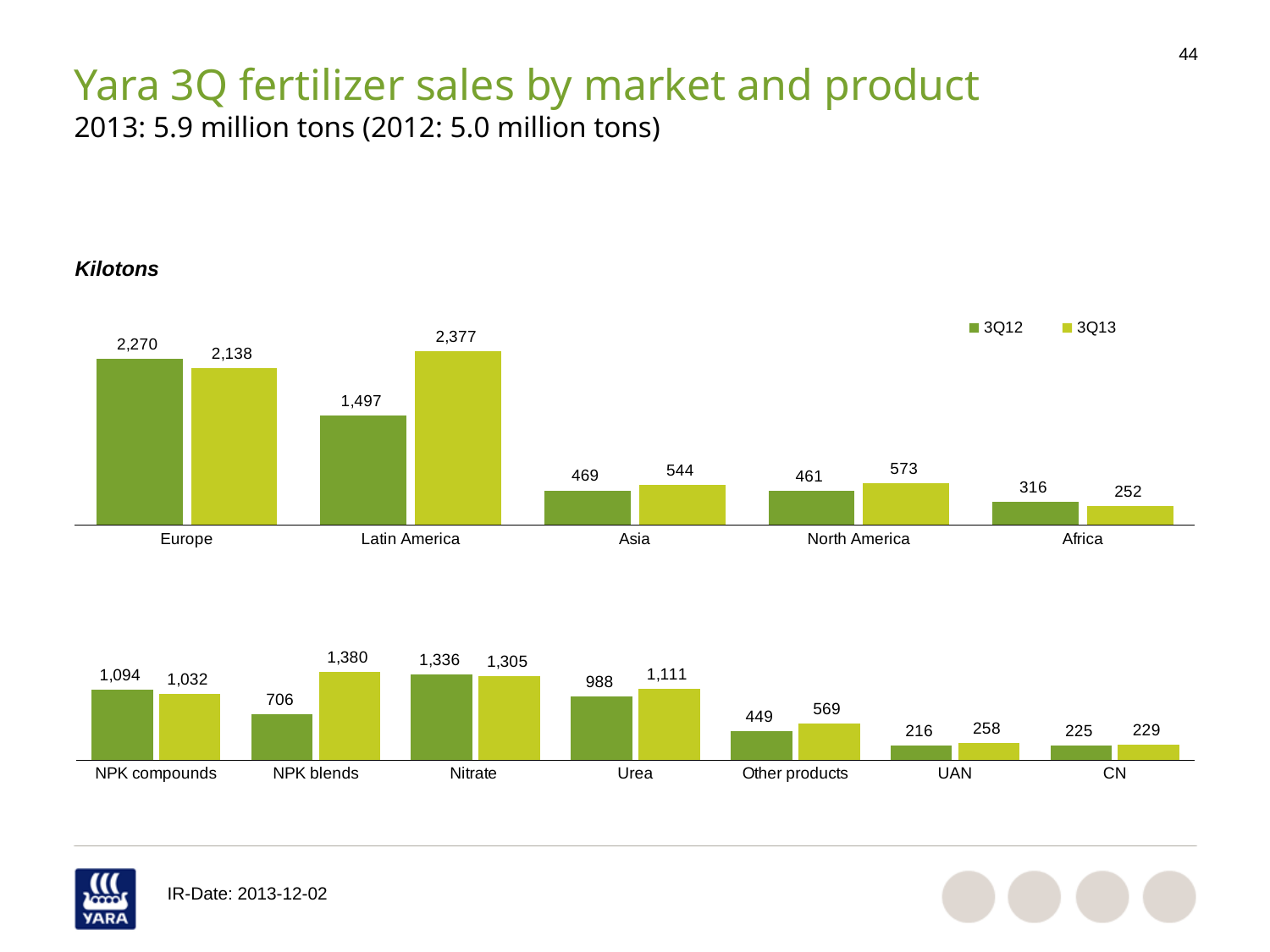
In the top chart (sales by market), which market has the lowest 3Q12 value? Africa What type of chart is the bottom chart (sales by product)? Bar chart In the bottom chart (sales by product), which product has the lowest 3Q12 value? UAN In the top chart (sales by market), what is the 3Q13 value for Latin America? 2,377 In the top chart (sales by market), what is the difference between the 3Q13 and 3Q12 values for Latin America? 880 In the top chart (sales by market), how many markets are shown on the x axis? 5 In the top chart (sales by market), which market has the highest 3Q13 value? Latin America In the top chart (sales by market), what is the 3Q12 value for Africa? 316 In the bottom chart (sales by product), what is the difference between the 3Q13 and 3Q12 values for Urea? 123 In the bottom chart (sales by product), is the 3Q12 value for Nitrate larger or the 3Q13 value for Nitrate? 3Q12 In the bottom chart (sales by product), what is the 3Q13 value for NPK blends? 1,380